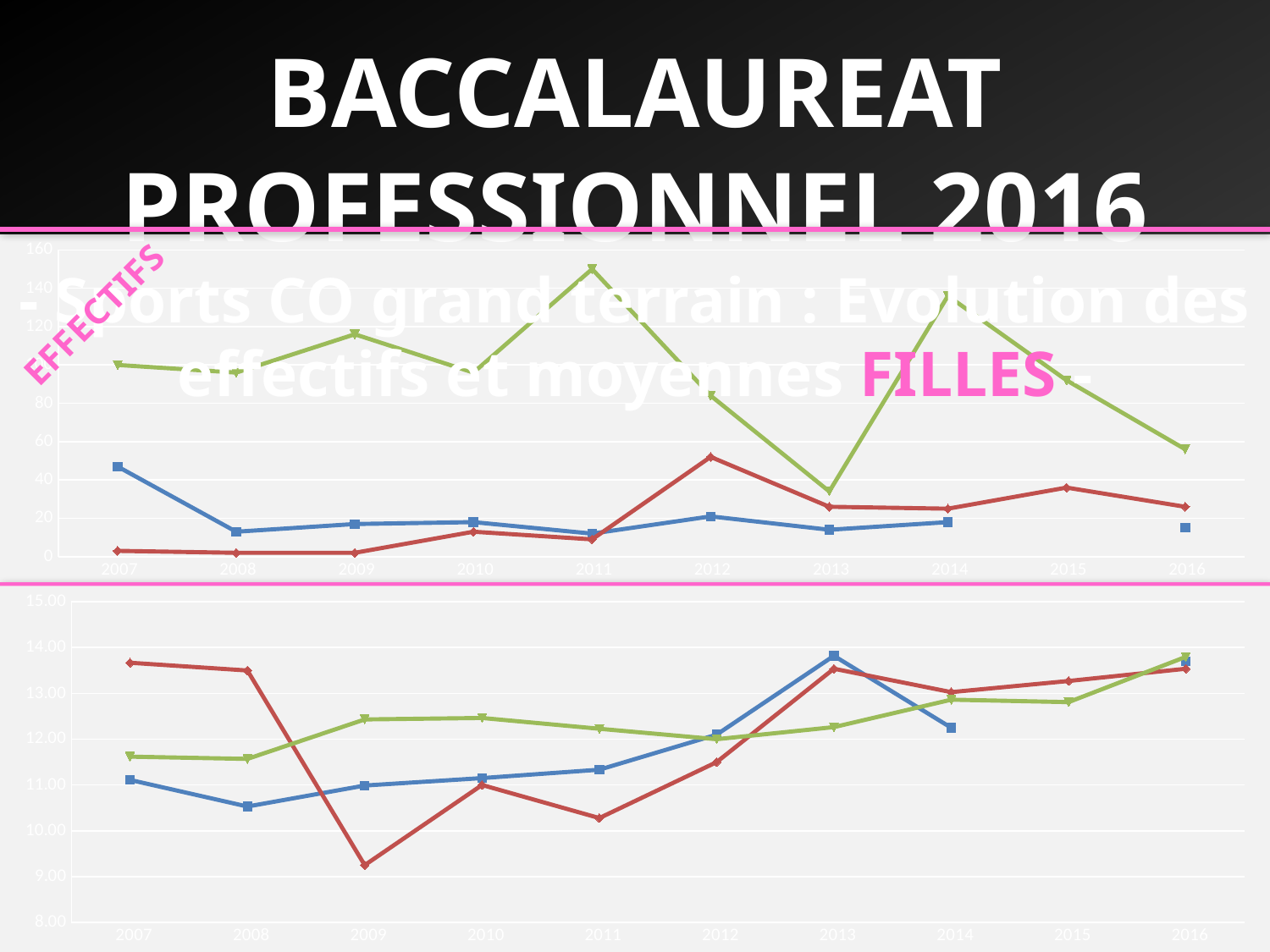
In the top chart (EFFECTIFS), which line has the larger value in 2013, the green line or the red line? green line In the bottom chart, in which year does the red line reach its lowest value? 2009 In the top chart (EFFECTIFS), in which year does the green line reach its highest value? 2011 In the bottom chart, is the value of the red line in 2009 greater or less than 10.00? less In the top chart (EFFECTIFS), in which year does the red line reach its highest value? 2012 What is the label written along the y axis of the top chart? EFFECTIFS In the top chart (EFFECTIFS), is the value of the green line in 2011 greater or less than 140? greater How many years are shown on the x axis of the top chart (EFFECTIFS)? 10 In the bottom chart, is the value of the green line in 2016 greater or less than 13.00? greater In the top chart (EFFECTIFS), in which year does the green line reach its lowest value? 2013 What kind of chart is the top chart (EFFECTIFS)? line chart